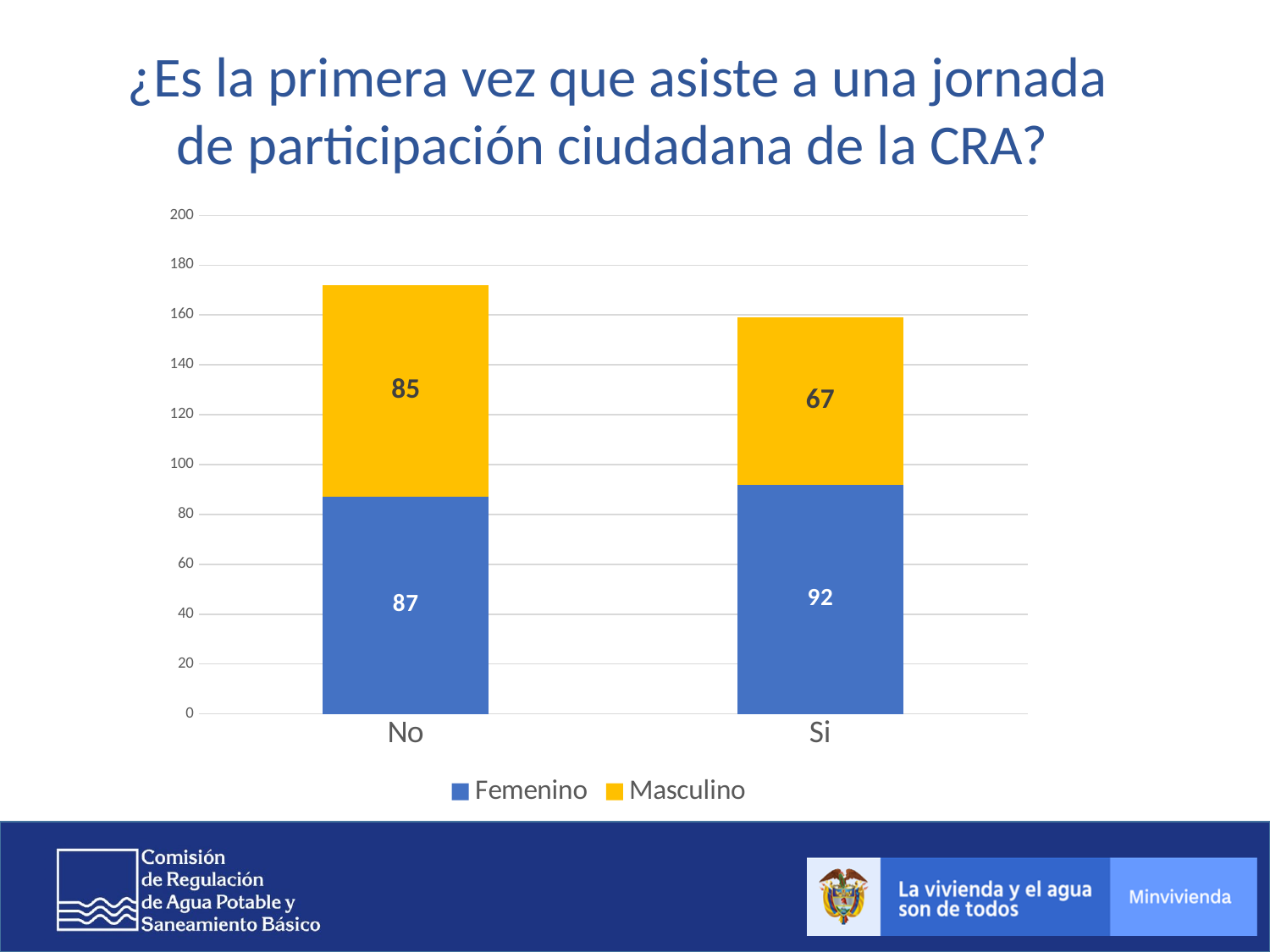
What kind of chart is shown on the slide? Stacked bar chart What is the difference between the Femenino values for Si and No? 5 Which category has the lowest Masculino value? Si What is the Masculino value for the Si category? 67 How many categories are shown on the x axis? 2 What is the Femenino value for the No category? 87 What is the Femenino value for the Si category? 92 What is the total of the stacked bar for No? 172 How many series does the legend list? 2 What is the total of the stacked bar for Si? 159 Which category has the higher Masculino value, No or Si? No What is the Masculino value for the No category? 85